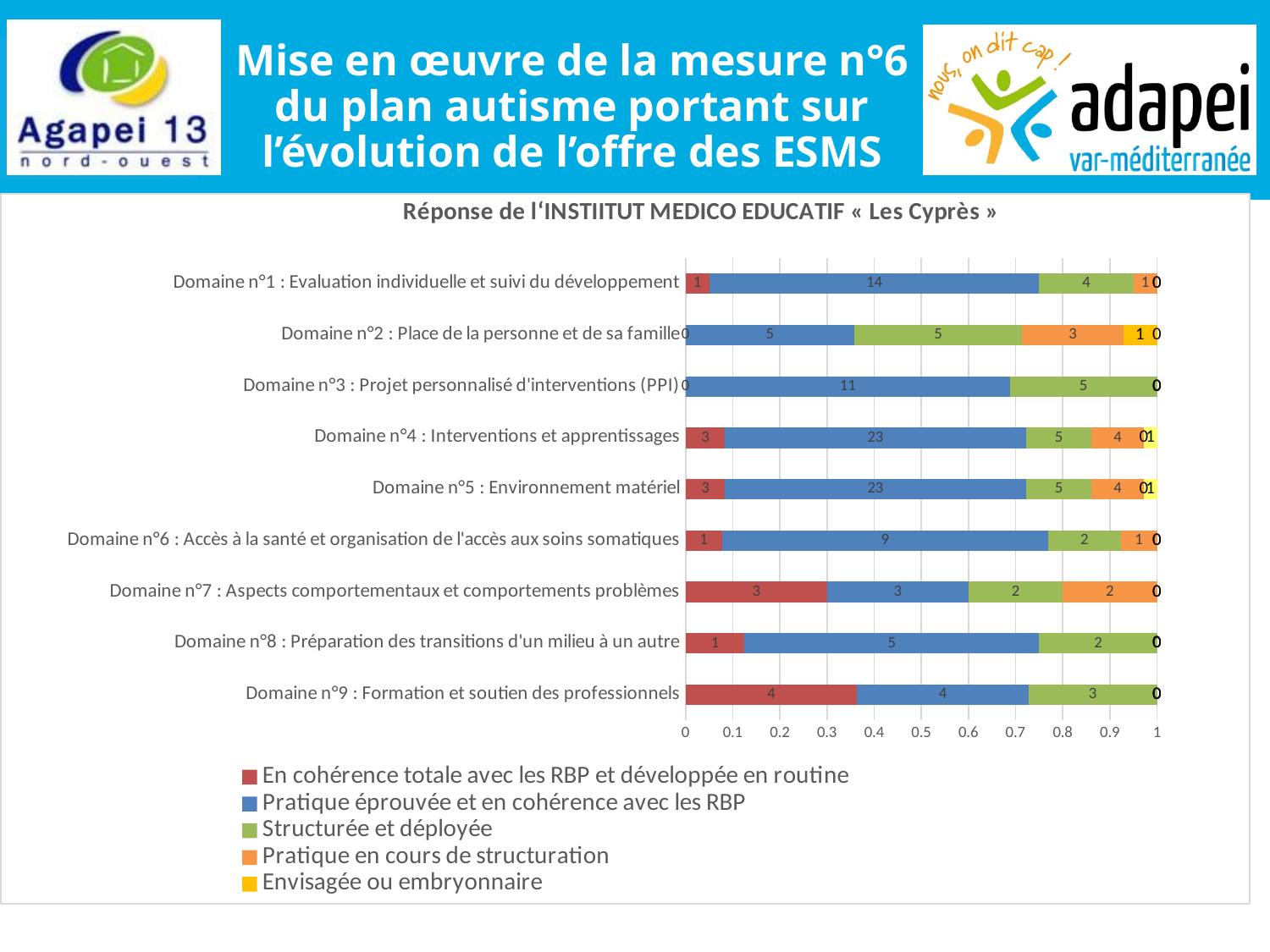
How many domains (categories) are plotted in the chart? 9 What is the difference between the 'Pratique éprouvée et en cohérence avec les RBP' values for Domaine n°4 and Domaine n°1? 9 Which domain has the highest value for 'En cohérence totale avec les RBP et développée en routine'? Domaine n°9 : Formation et soutien des professionnels What is the value of 'Pratique éprouvée et en cohérence avec les RBP' for Domaine n°1 : Evaluation individuelle et suivi du développement? 14 What is the total of all labelled values in the bar for Domaine n°7 : Aspects comportementaux et comportements problèmes? 10 What is the value of 'En cohérence totale avec les RBP et développée en routine' for Domaine n°9 : Formation et soutien des professionnels? 4 What is the value of 'Pratique éprouvée et en cohérence avec les RBP' for Domaine n°4 : Interventions et apprentissages? 23 What is the value of 'Pratique éprouvée et en cohérence avec les RBP' for Domaine n°3 : Projet personnalisé d'interventions (PPI)? 11 What type of chart is shown on the slide? bar chart What is the title of the chart? Réponse de l'INSTIITUT MEDICO EDUCATIF « Les Cyprès » How many series does the legend list? 5 Which is larger: the 'Pratique éprouvée et en cohérence avec les RBP' value for Domaine n°4 or for Domaine n°1? Domaine n°4